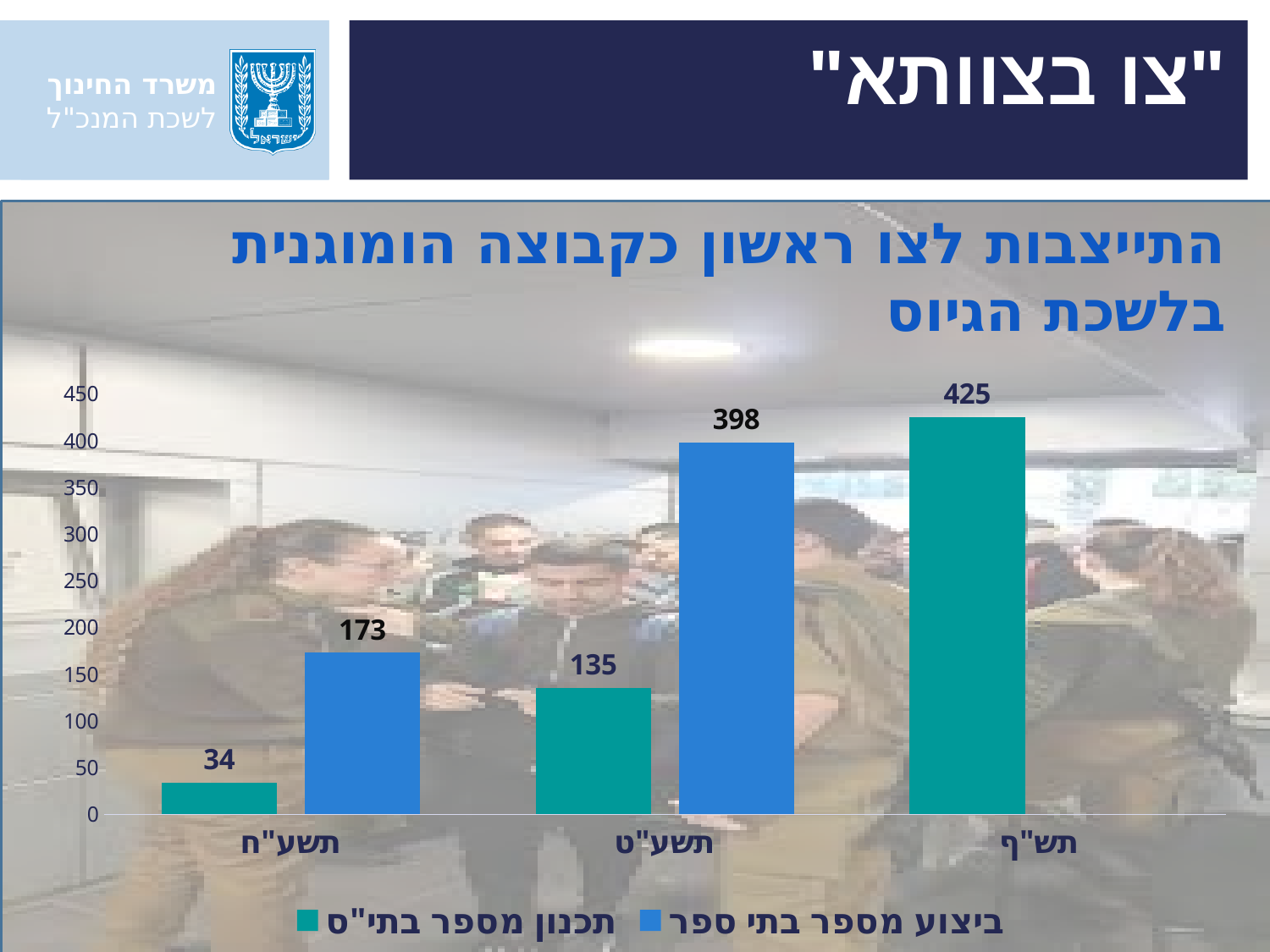
How many series does the legend list? 2 What is the value of the תכנון מספר בתי ספר bar for תשע"ט? 135 What is the value of the ביצוע מספר בתי"ס bar for תשע"ח? 173 How many categories are shown on the x axis? 3 For תשע"ח, which is larger: the ביצוע מספר בתי"ס value or the תכנון מספר בתי ספר value? ביצוע מספר בתי ספר Which category has the lowest ביצוע מספר בתי"ס value? תשע"ח What is the difference between the תכנון מספר בתי ספר value and the ביצוע מספר בתי"ס value for תשע"ט? 263 Which category has the highest ביצוע מספר בתי"ס value? תשע"ט What is the value of the תכנון מספר בתי ספר bar for תשע"ח? 34 What kind of chart is shown on the slide? bar chart